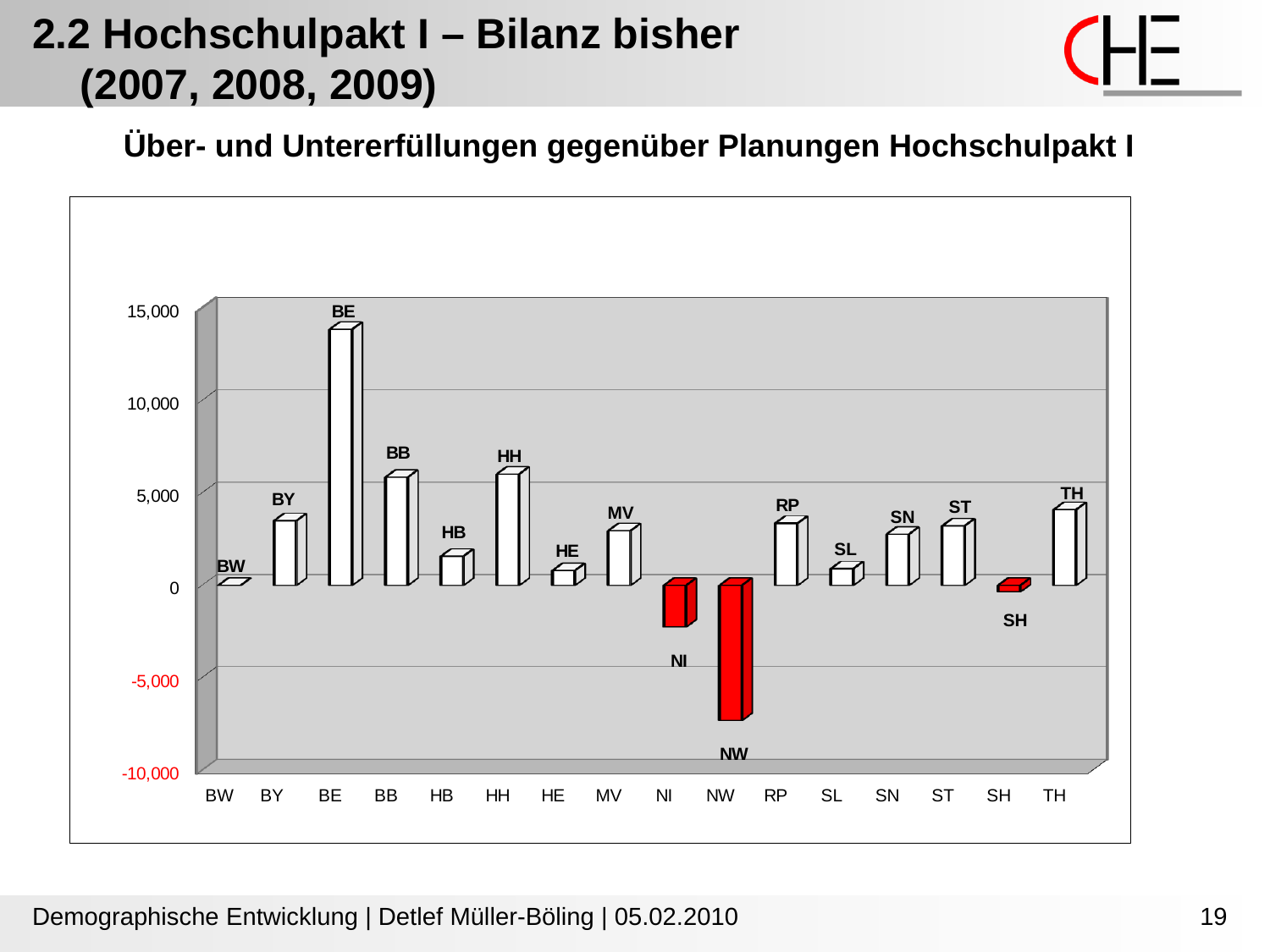
Is the value for BE greater or less than 10,000? greater Is the value for NI greater or less than -5,000? greater Which is larger, the value for HH or the value for HE? HH Is the value for BY greater or less than 5,000? less Which is larger, the value for BE or the value for BB? BE What is the title shown above the chart? Über- und Untererfüllungen gegenüber Planungen Hochschulpakt I How many categories (federal states) are shown on the x axis of the chart? 16 Which category has the lowest value in the chart? NW What kind of chart is shown on the slide? bar chart Which category has the highest value in the chart? BE How many categories in the chart have a negative value? 3